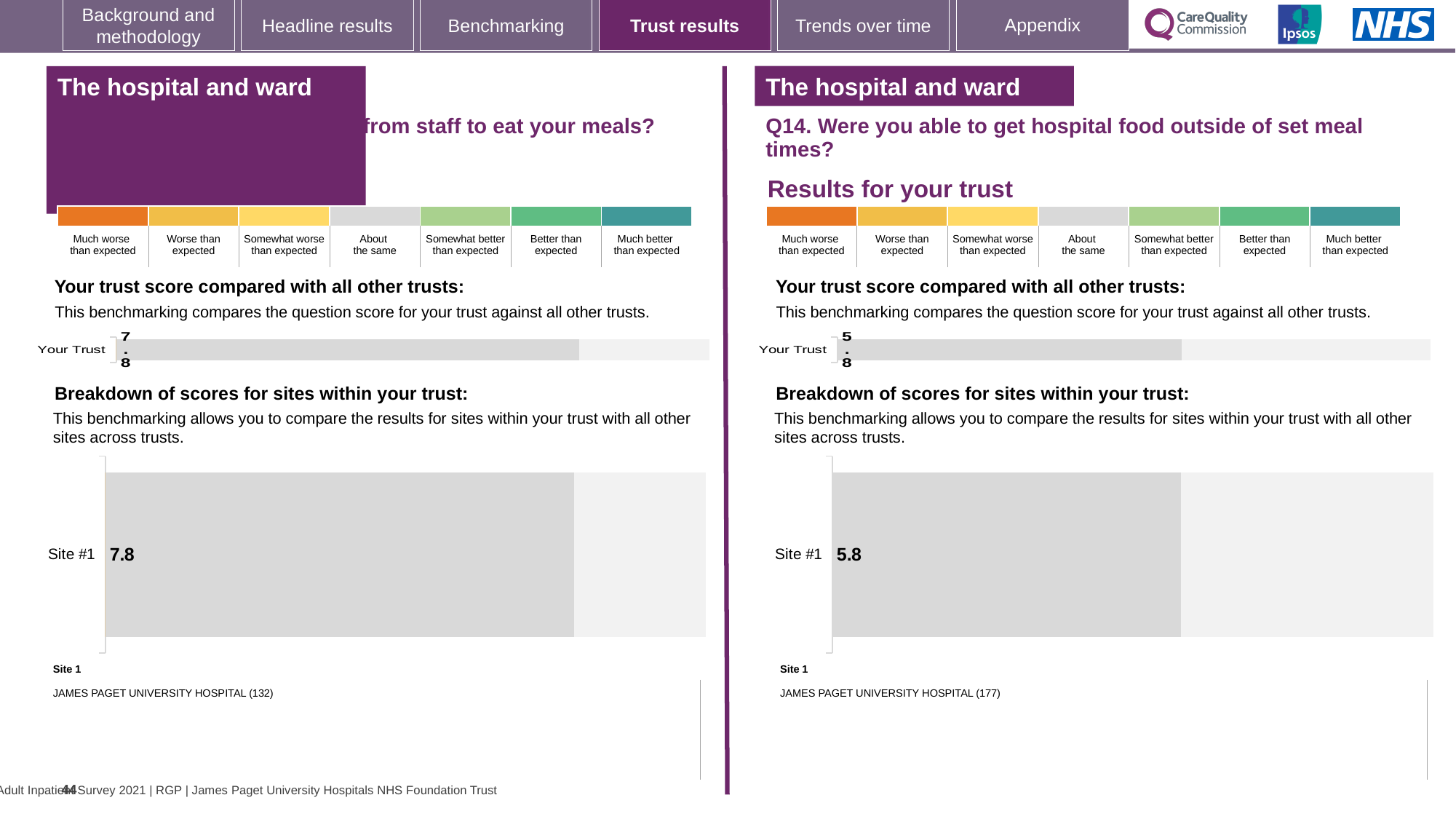
Which is larger: the Site #1 score in the left-hand breakdown chart or the Site #1 score in the right-hand (Q14) breakdown chart? Left-hand chart (7.8) How many sites are shown in the 'Breakdown of scores for sites within your trust' chart on the right-hand side (Q14)? 1 What kind of chart is used to show the Site #1 score in the breakdown section on the left-hand side? Bar chart In the 'Breakdown of scores for sites within your trust' chart on the right-hand side (Q14), what is the score for Site #1? 5.8 On the right-hand side of the slide (Q14), what is the score shown for Your Trust in the 'Your trust score compared with all other trusts' chart? 5.8 Which site name is listed under Site 1 in the left-hand breakdown section? JAMES PAGET UNIVERSITY HOSPITAL (132) On the left-hand side of the slide, what is the score shown for Your Trust in the 'Your trust score compared with all other trusts' chart? 7.8 What is the difference between the Your Trust score on the left-hand side (7.8) and the Your Trust score on the right-hand side (5.8)? 2.0 In the 'Breakdown of scores for sites within your trust' chart on the left-hand side, what is the score for Site #1? 7.8 Which site name is listed under Site 1 in the right-hand (Q14) breakdown section? JAMES PAGET UNIVERSITY HOSPITAL (177) Is the Your Trust score in the right-hand (Q14) chart greater or less than 7? less